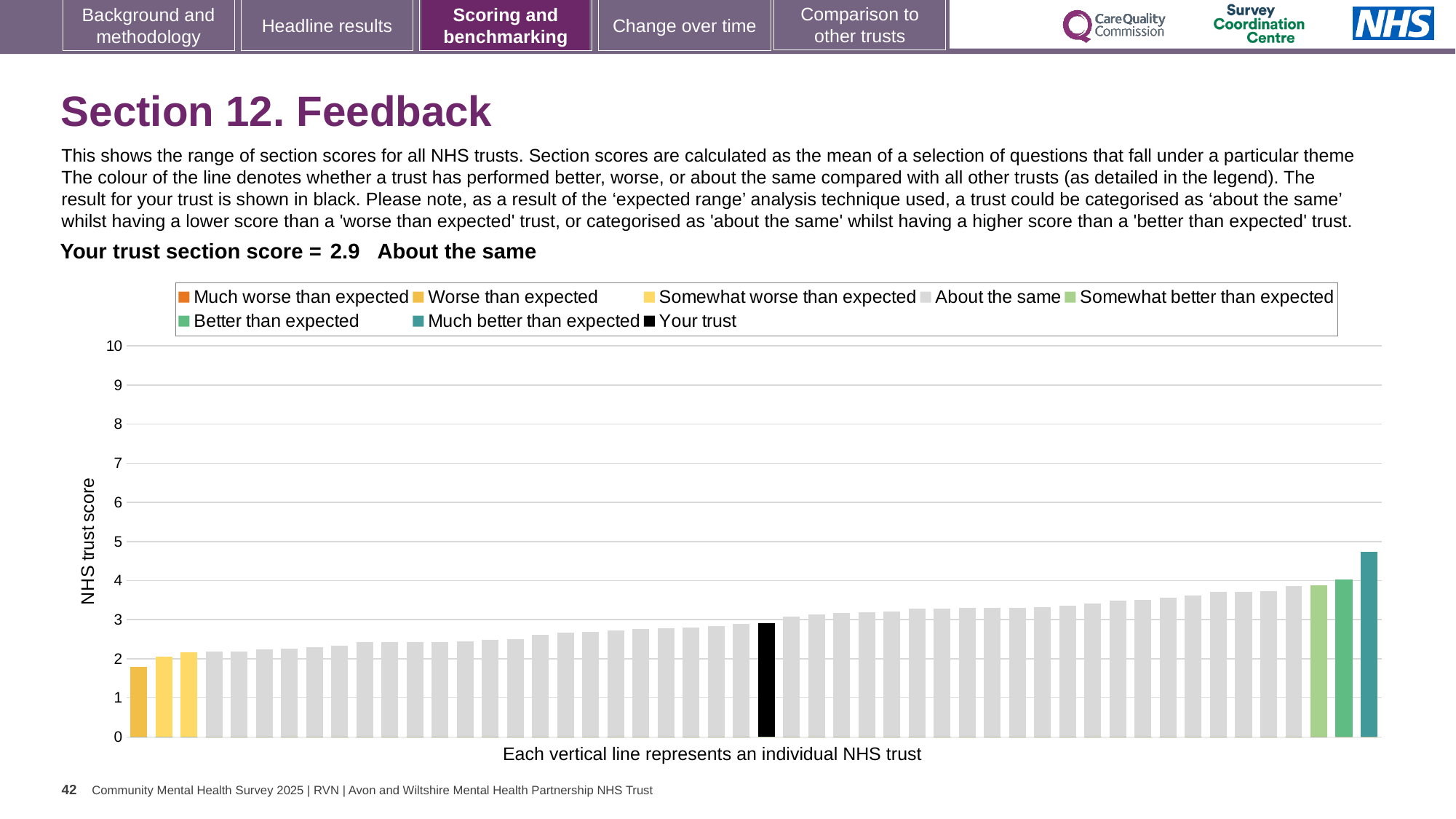
What does the label under the x axis say each vertical line represents? an individual NHS trust Which category is your trust placed in for this section? About the same What is the title of the vertical axis? NHS trust score Do the bar values rise or fall from left to right along the x axis? rise How many bars are coloured black for your trust? 1 What kind of chart is shown on the slide? bar chart Which legend category does the tallest bar belong to? Much better than expected Is the value for the tallest bar greater or less than 4? greater Is the value for the shortest bar greater or less than 2? less How many entries does the chart legend list? 8 Is the value for your trust greater or less than 3? less What is the section score for your trust shown on the slide? 2.9